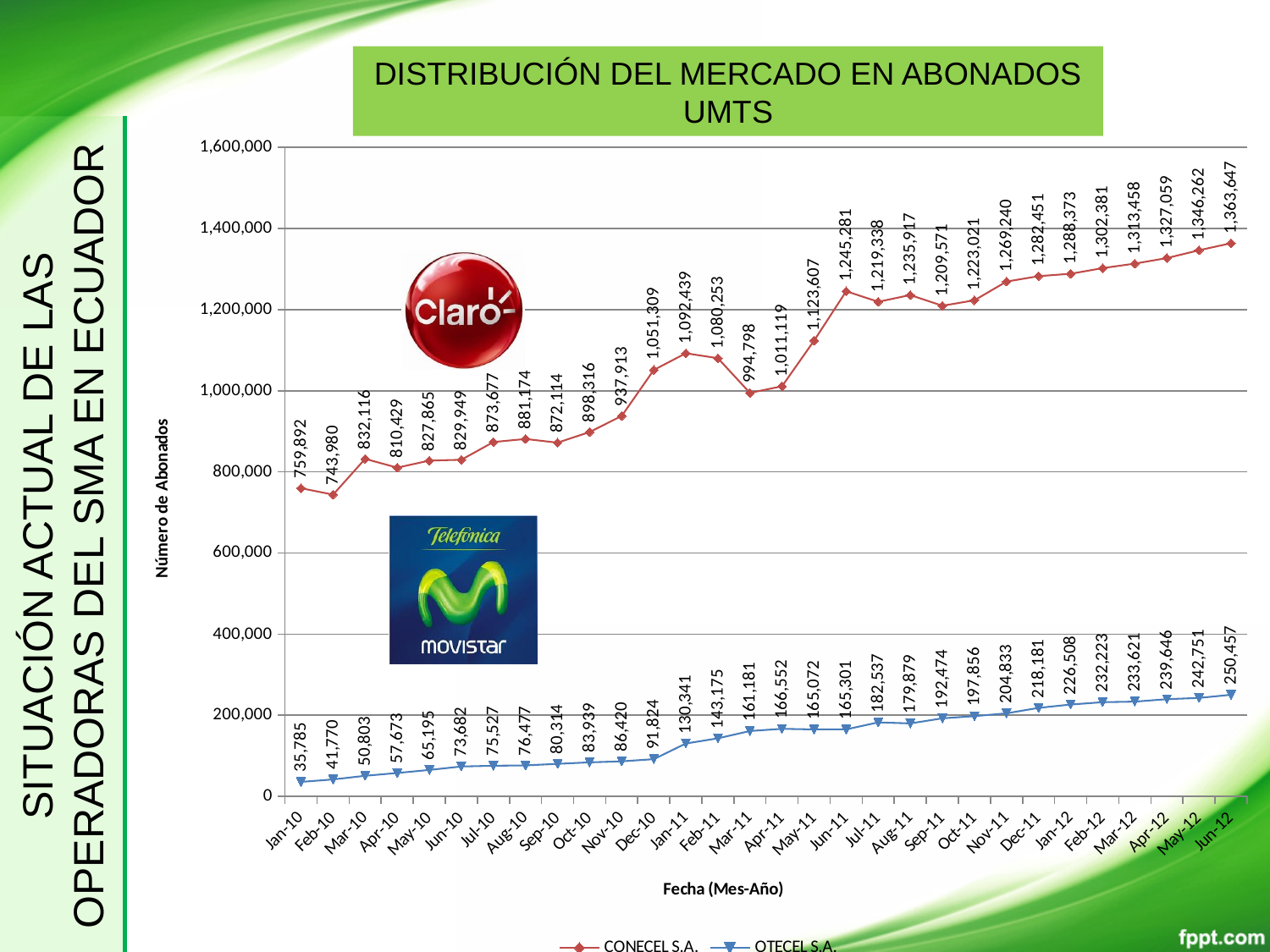
What is the difference between CONECEL S.A. and OTECEL S.A. in Jun-12? 1,113,190 How many months are plotted on the x axis? 30 What is the value for CONECEL S.A. in Jun-12? 1,363,647 Which is larger for CONECEL S.A., the value in Jan-11 or the value in Mar-11? Jan-11 In which month does OTECEL S.A. have its highest value? Jun-12 In which month does CONECEL S.A. have its lowest value? Feb-10 By how much did CONECEL S.A. increase from Jan-10 to Jun-12? 603,755 What type of chart is shown on the slide? Line chart What is the value for OTECEL S.A. in Jan-10? 35,785 What is the value for OTECEL S.A. in Dec-11? 218,181 What is the title of the chart? DISTRIBUCIÓN DEL MERCADO EN ABONADOS UMTS How many series does the legend list? 2